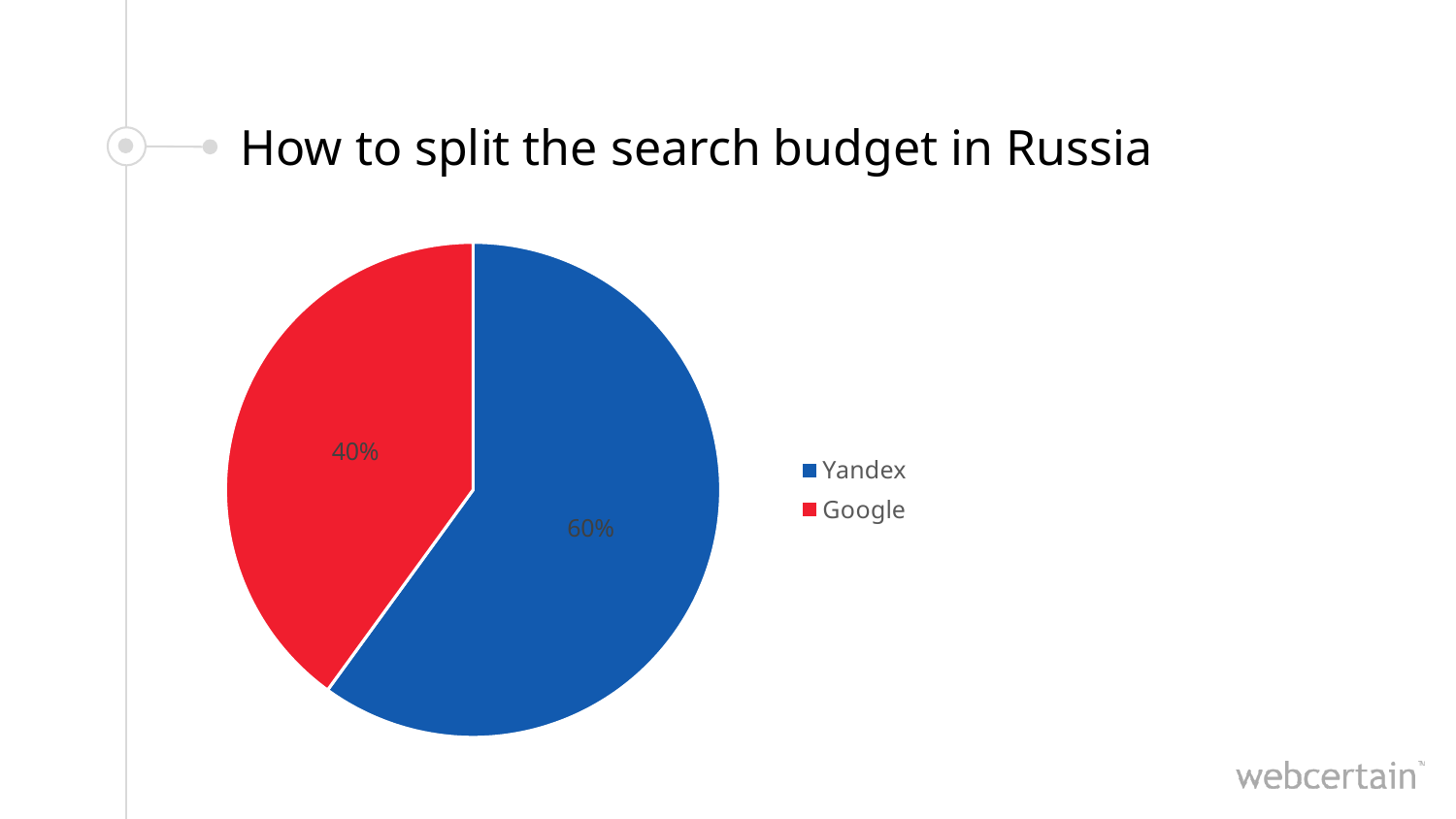
What is the title of the slide? How to split the search budget in Russia What share of the search budget does Yandex receive? 60% What kind of chart is shown on the slide? Pie chart How many slices does the pie chart have? 2 What share of the search budget does Google receive? 40% What colour is the Yandex slice? Blue How many entries does the legend list? 2 Which search engine has the smallest share of the budget? Google What is the share of the pie taken by the Google slice? 40% Which has a larger share of the budget, Google or Yandex? Yandex What is the difference in percentage points between the Yandex and Google shares? 20 Which search engine has the largest share of the budget? Yandex